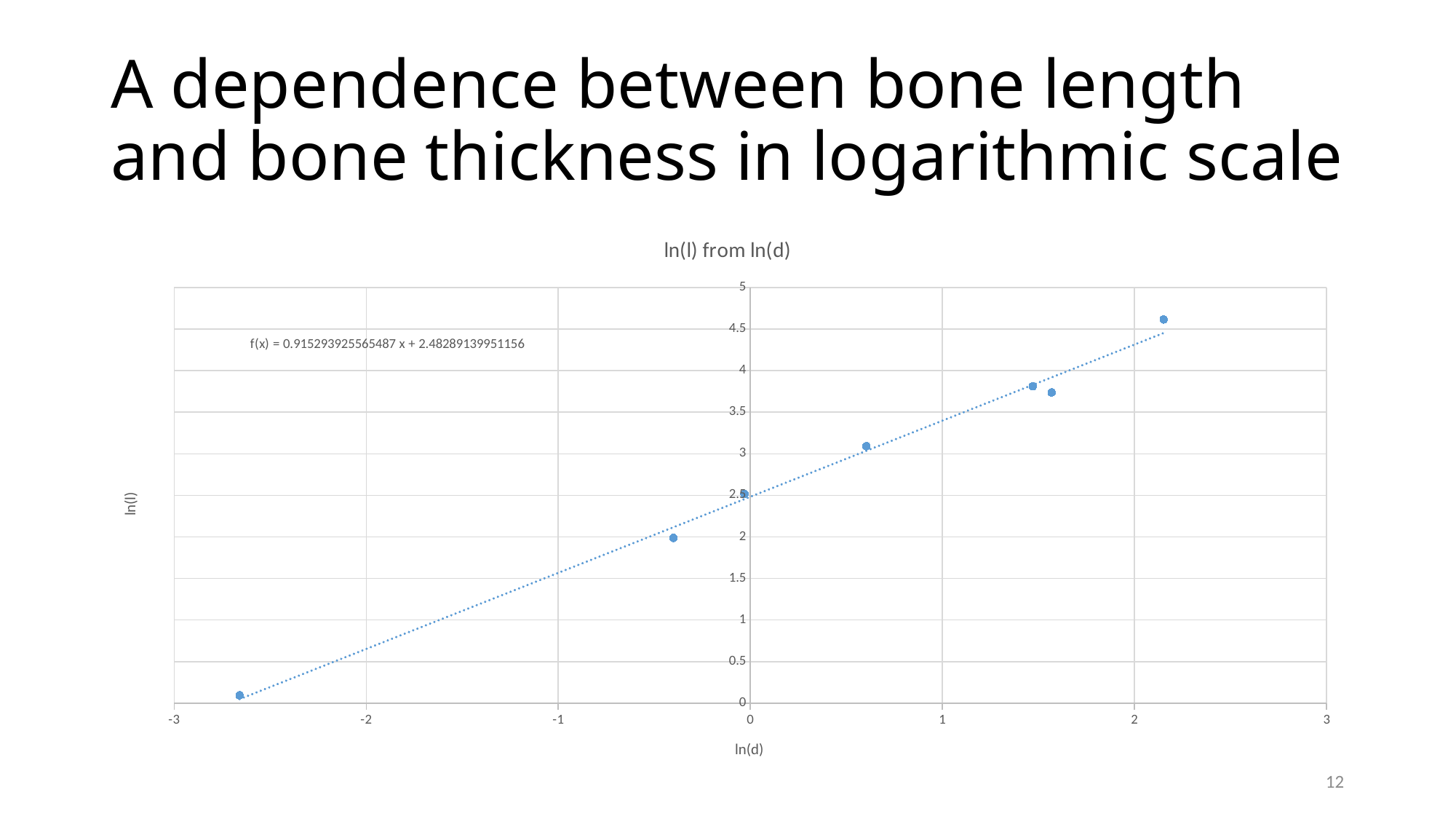
What is the title of the chart? ln(l) from ln(d) What trendline equation is printed on the chart? f(x) = 0.915293925565487 x + 2.48289139951156 Is the ln(l) value of the rightmost data point greater or less than 4.5? greater Which data point has the highest ln(l) value: the leftmost point or the rightmost point? the rightmost point Is the ln(l) value of the data point near ln(d) = 0.6 greater or less than 3? greater What kind of chart is shown on the slide? scatter chart Is the ln(l) value of the data point near ln(d) = -0.4 greater or less than 1.5? greater What is the lowest value shown on the x axis? -3 What is the highest value shown on the y axis? 5 Do the ln(l) values rise or fall as ln(d) increases along the x axis? rise How many data points are plotted in the chart? 7